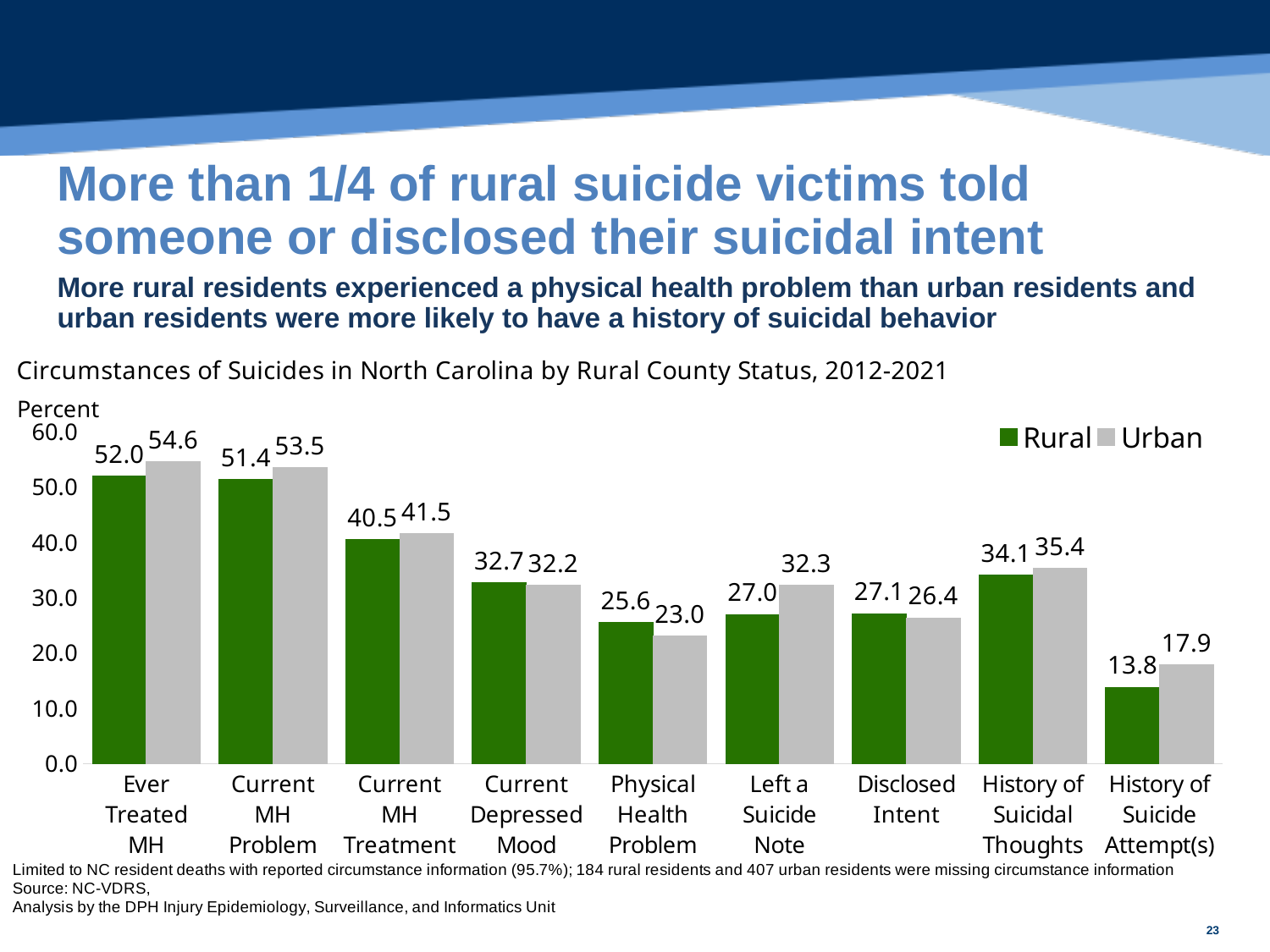
What kind of chart is shown on the slide? Bar chart Is the Rural value for Current MH Treatment greater or less than 50.0? less What colour are the Rural bars? Green What is the Urban value for History of Suicide Attempt(s)? 17.9 What is the Urban value for Left a Suicide Note? 32.3 Which category has the lowest Rural value? History of Suicide Attempt(s) How many series does the legend list? 2 How many categories are shown on the x axis? 9 Which category has the highest Urban value? Ever Treated MH Which is larger for Physical Health Problem, the Rural value or the Urban value? Rural What is the difference between the Urban and Rural values for Left a Suicide Note? 5.3 What is the Rural value for Ever Treated MH? 52.0